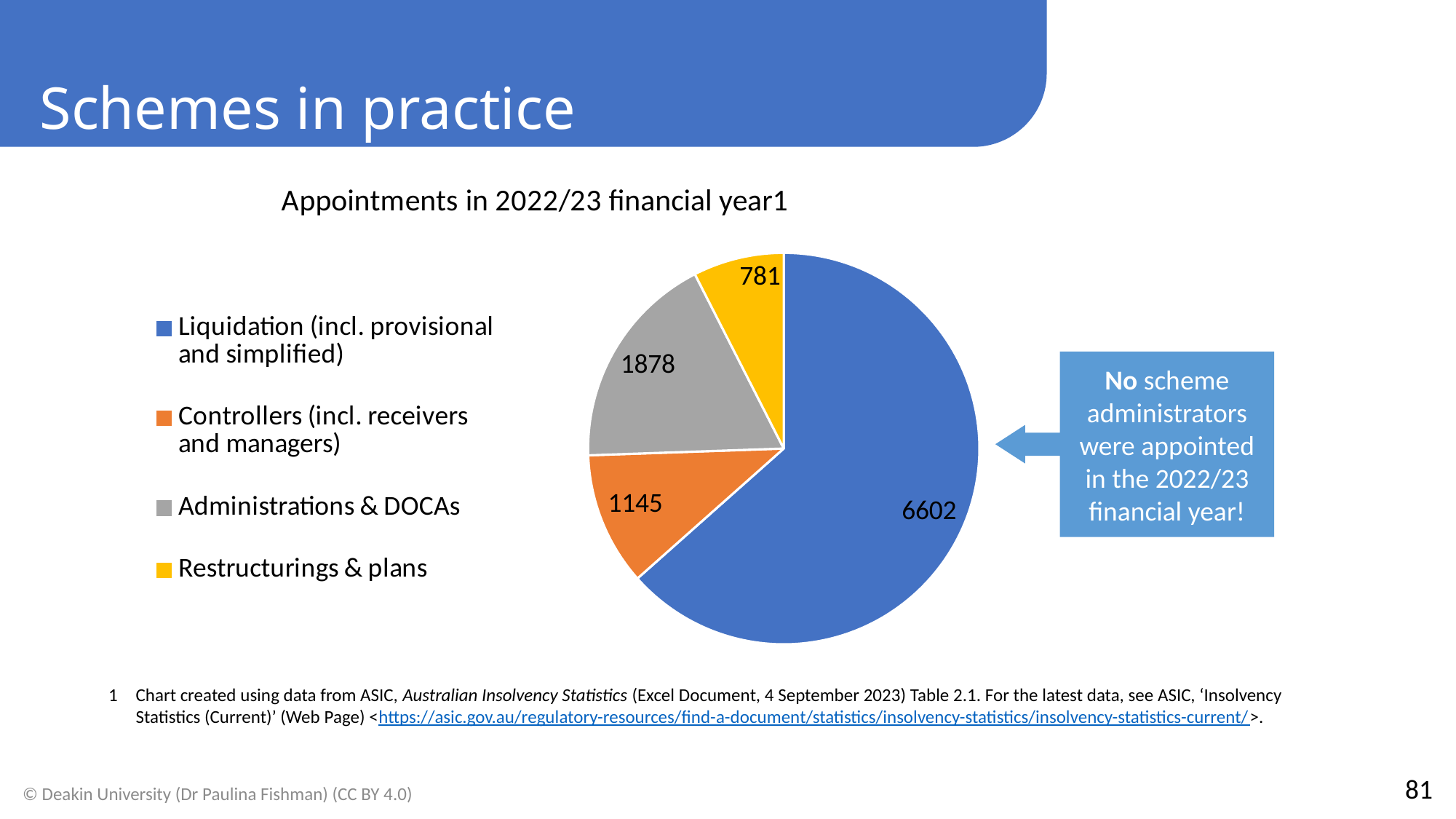
What type of chart is shown on the slide? Pie chart How many appointments were Controllers (incl. receivers and managers)? 1145 How many categories does the pie chart show? 4 How many appointments were Restructurings & plans? 781 What is the difference between the Administrations & DOCAs value and the Controllers value? 733 Which is larger, Administrations & DOCAs or Controllers (incl. receivers and managers)? Administrations & DOCAs Which category has the smallest slice of the pie? Restructurings & plans How many appointments were Liquidation (incl. provisional and simplified)? 6602 How many appointments were Administrations & DOCAs? 1878 What colour is the slice for Restructurings & plans? Yellow Which category has the largest slice of the pie? Liquidation (incl. provisional and simplified) What is the title of the chart? Appointments in 2022/23 financial year1